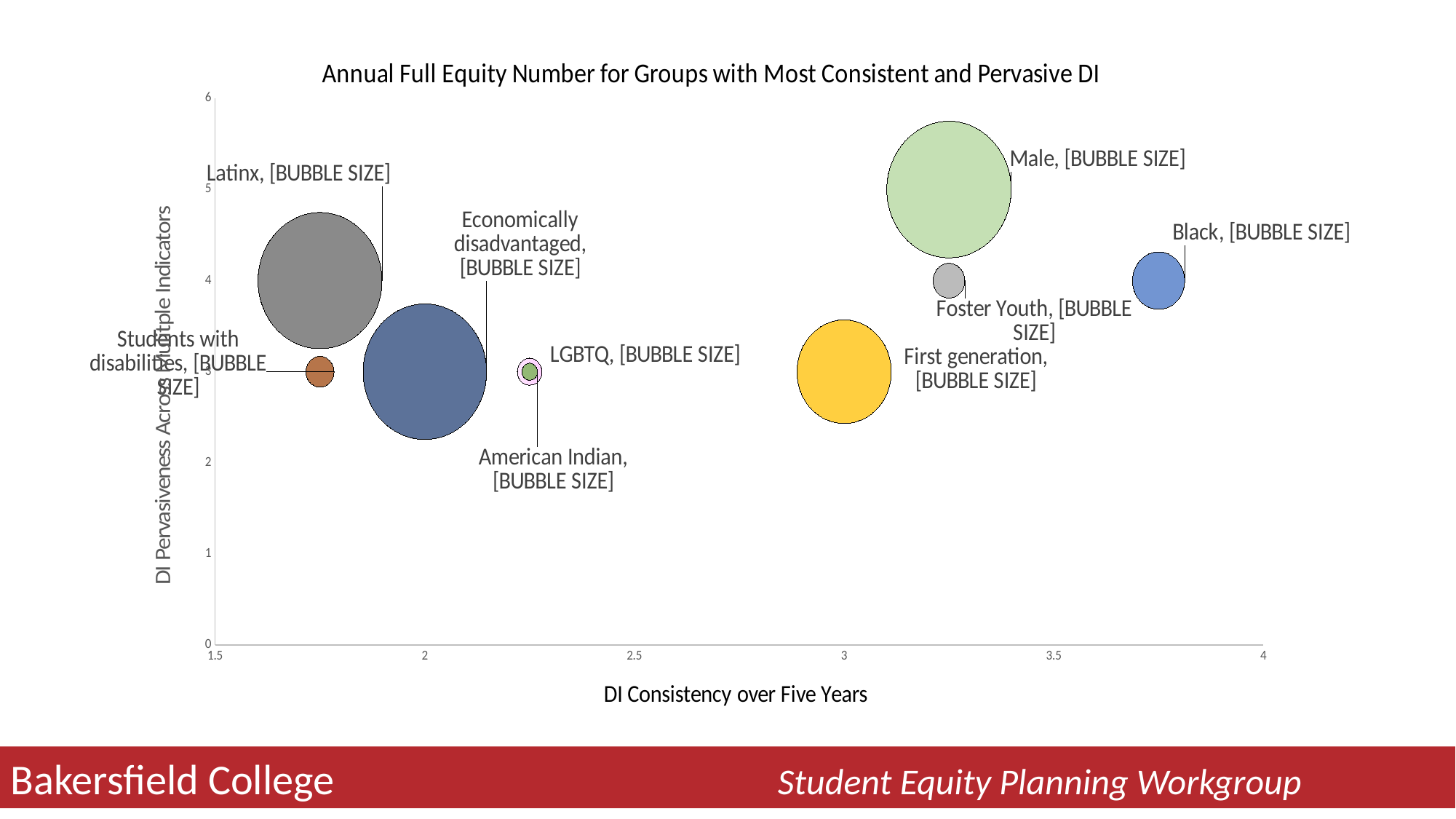
What is the title of the chart? Annual Full Equity Number for Groups with Most Consistent and Pervasive DI Which group has a higher DI Pervasiveness Across Multiple Indicators value, Male or Black? Male What type of chart is shown on the slide? Bubble chart What is the DI Pervasiveness Across Multiple Indicators value for the Male group? 5 What is the DI Consistency over Five Years value for the Economically disadvantaged group? 2 Is the DI Consistency over Five Years value for the Black group greater or less than 3.5? greater Is the DI Consistency over Five Years value for the Latinx group greater or less than 2? less Which group has the highest DI Pervasiveness Across Multiple Indicators value? Male How many groups (bubbles) are plotted on the chart? 9 What is the label of the x axis? DI Consistency over Five Years What is the DI Pervasiveness Across Multiple Indicators value for the Latinx group? 4